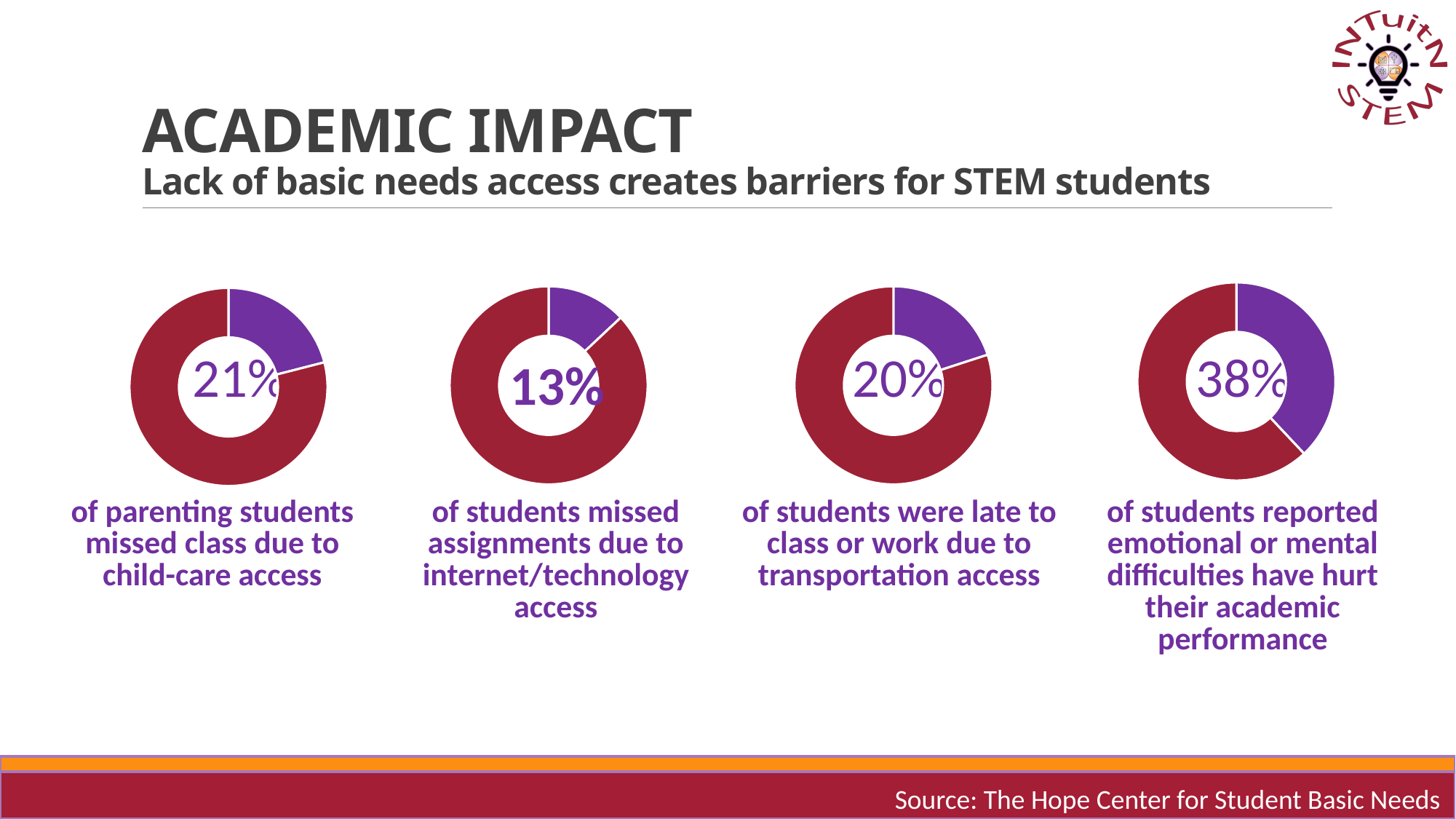
What is the difference between the percentage in the rightmost donut chart (38%) and the percentage in the second chart from the left (13%)? 25% In the third donut chart from the left, what percentage of students were late to class or work due to transportation access? 20% In the leftmost donut chart, what percentage of parenting students missed class due to child-care access? 21% In the rightmost donut chart, what percentage of students reported emotional or mental difficulties have hurt their academic performance? 38% Which of the four donut charts shows the highest percentage? Students reporting emotional or mental difficulties hurt their academic performance (38%) What colour is used for the highlighted slice representing the stated percentage in each donut chart? Purple Which is larger: the percentage of students late due to transportation access or the percentage reporting emotional or mental difficulties hurt their performance? Emotional or mental difficulties (38%) How many donut charts are shown on the slide? 4 In the leftmost donut chart, what share of the ring is the dark red (non-highlighted) portion? 79% In the second donut chart from the left, what percentage of students missed assignments due to internet/technology access? 13% What kind of chart is used to display the percentages on this slide? Donut chart Which of the four donut charts shows the lowest percentage? Students who missed assignments due to internet/technology access (13%)